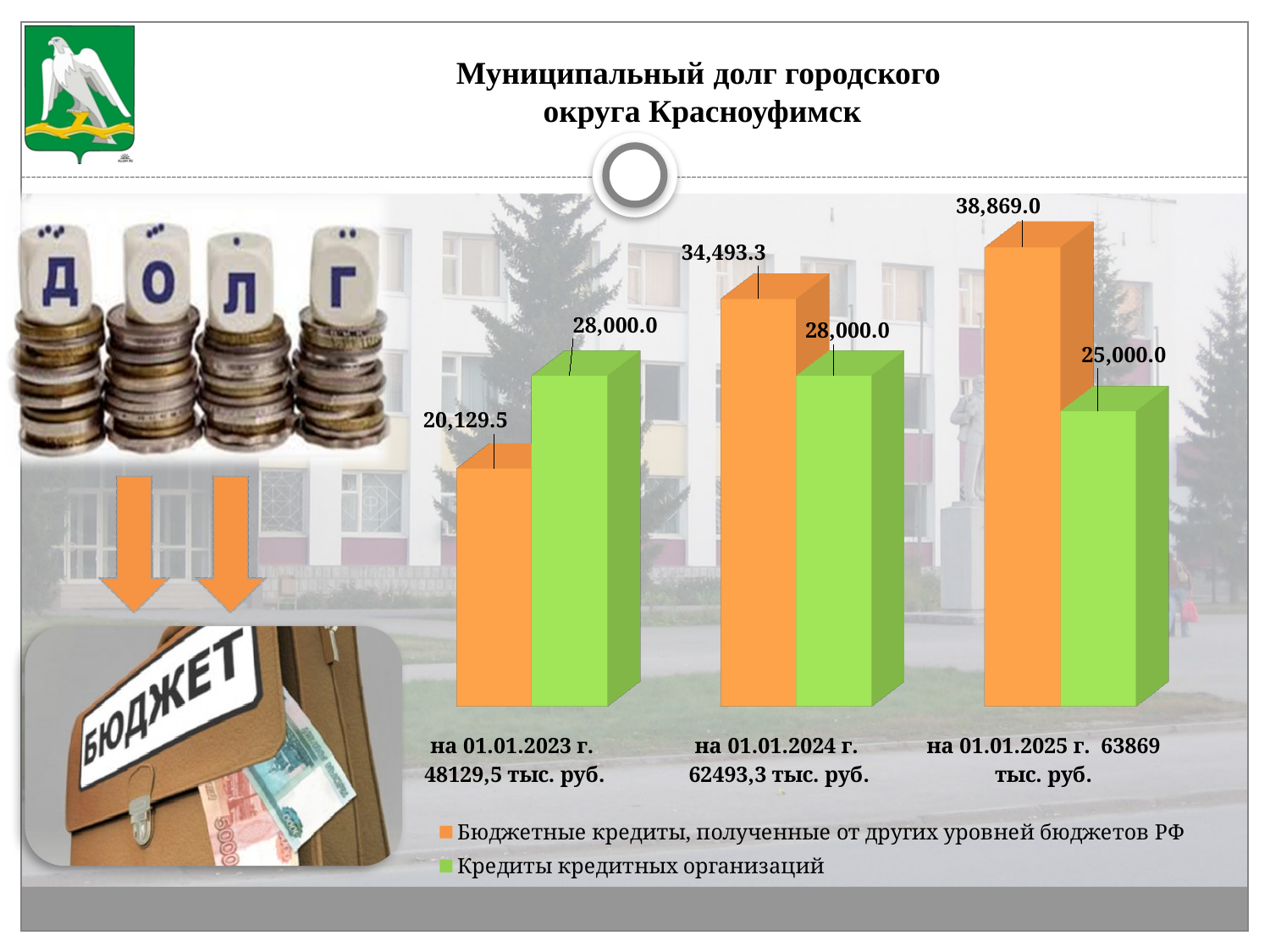
For 'на 01.01.2023 г.', which series has the larger value: 'Бюджетные кредиты, полученные от других уровней бюджетов РФ' or 'Кредиты кредитных организаций'? Кредиты кредитных организаций How many categories are shown on the x axis of the chart? 3 What is the value of 'Бюджетные кредиты, полученные от других уровней бюджетов РФ' for 'на 01.01.2024 г.'? 34,493.3 For 'на 01.01.2024 г.', which series has the larger value: 'Бюджетные кредиты, полученные от других уровней бюджетов РФ' or 'Кредиты кредитных организаций'? Бюджетные кредиты, полученные от других уровней бюджетов РФ What is the value of 'Бюджетные кредиты, полученные от других уровней бюджетов РФ' for 'на 01.01.2023 г.'? 20,129.5 What kind of chart is shown on the slide? bar chart How many series does the chart legend list? 2 In which category is 'Бюджетные кредиты, полученные от других уровней бюджетов РФ' highest? на 01.01.2025 г. What is the value of 'Кредиты кредитных организаций' for 'на 01.01.2025 г.'? 25,000.0 Does the value of 'Бюджетные кредиты, полученные от других уровней бюджетов РФ' rise or fall from 'на 01.01.2023 г.' to 'на 01.01.2025 г.'? rise In which category is 'Кредиты кредитных организаций' lowest? на 01.01.2025 г. What is the difference between 'Бюджетные кредиты, полученные от других уровней бюджетов РФ' for 'на 01.01.2025 г.' and 'на 01.01.2024 г.'? 4,375.7